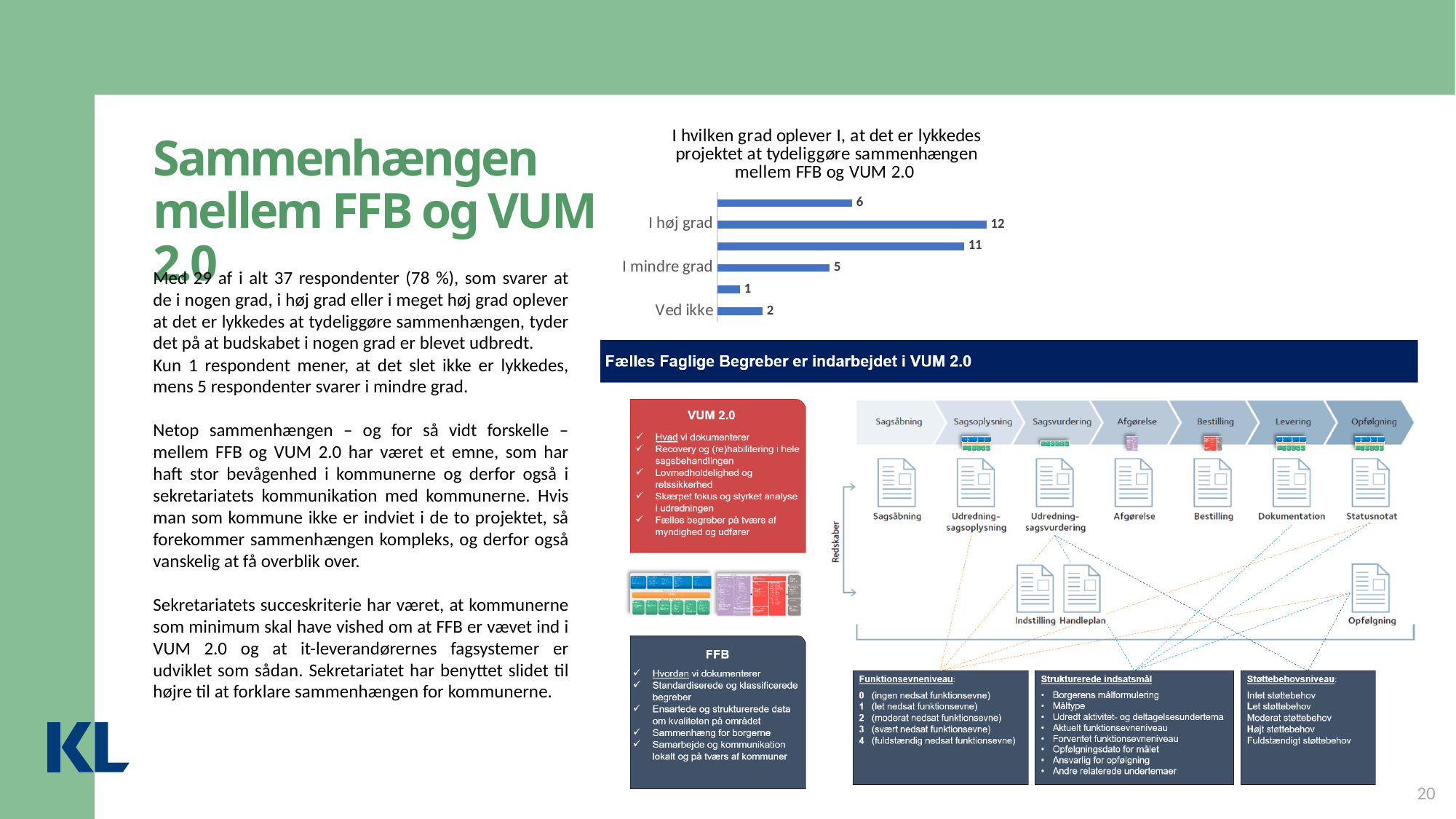
How many bars are plotted in the chart? 6 What is the difference between the values for "I mindre grad" and "Ved ikke"? 3 What is the value for "Ved ikke"? 2 What is the title of the chart? I hvilken grad oplever I, at det er lykkedes projektet at tydeliggøre sammenhængen mellem FFB og VUM 2.0 Which category has the highest value in the chart? I høj grad What is the largest data label shown on any bar in the chart? 12 Which is larger, the value for "I høj grad" or the value for "Ved ikke"? I høj grad What is the value for "I mindre grad"? 5 What kind of chart is shown on the slide? Bar chart What is the difference between the values for "I høj grad" and "I mindre grad"? 7 What is the value for "I høj grad"? 12 Which is larger, the value for "I mindre grad" or the value for "Ved ikke"? I mindre grad